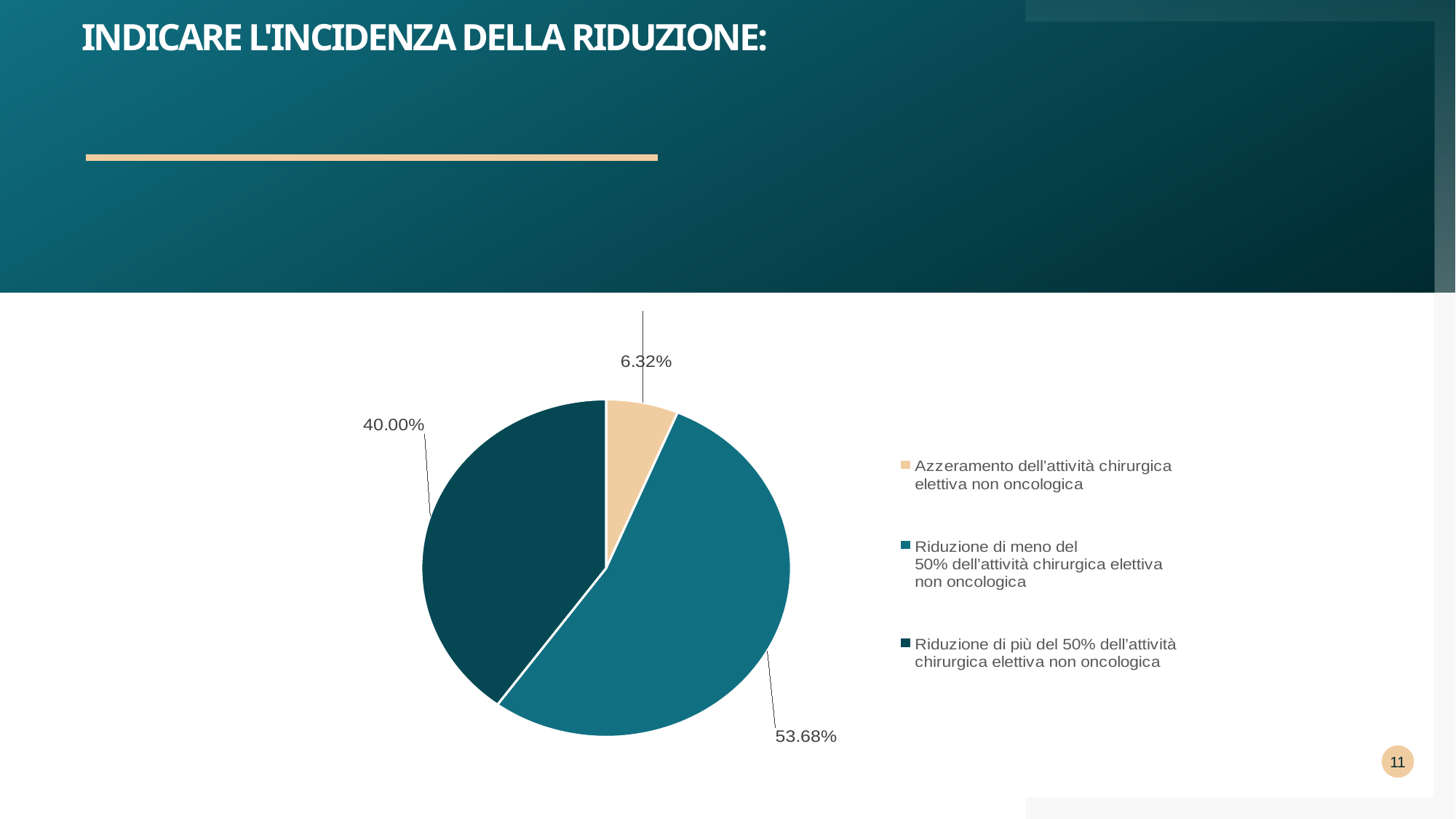
How many categories does the pie chart have? 3 What share of the pie is labelled for 'Azzeramento dell'attività chirurgica elettiva non oncologica'? 6.32% What kind of chart is shown on the slide? pie chart Which is larger: the 'Riduzione di più del 50%' slice or the 'Azzeramento' slice? Riduzione di più del 50% dell'attività chirurgica elettiva non oncologica How many entries does the legend list? 3 Which category has the smallest slice of the pie? Azzeramento dell'attività chirurgica elettiva non oncologica What is the title of the slide containing the pie chart? INDICARE L'INCIDENZA DELLA RIDUZIONE: What share of the pie is labelled for 'Riduzione di meno del 50% dell'attività chirurgica elettiva non oncologica'? 53.68% What is the difference in percentage points between the 'Riduzione di meno del 50%' slice and the 'Riduzione di più del 50%' slice? 13.68 What share of the pie is labelled for 'Riduzione di più del 50% dell'attività chirurgica elettiva non oncologica'? 40.00% What colour is the slice for 'Azzeramento dell'attività chirurgica elettiva non oncologica'? beige Which category has the largest slice of the pie? Riduzione di meno del 50% dell'attività chirurgica elettiva non oncologica